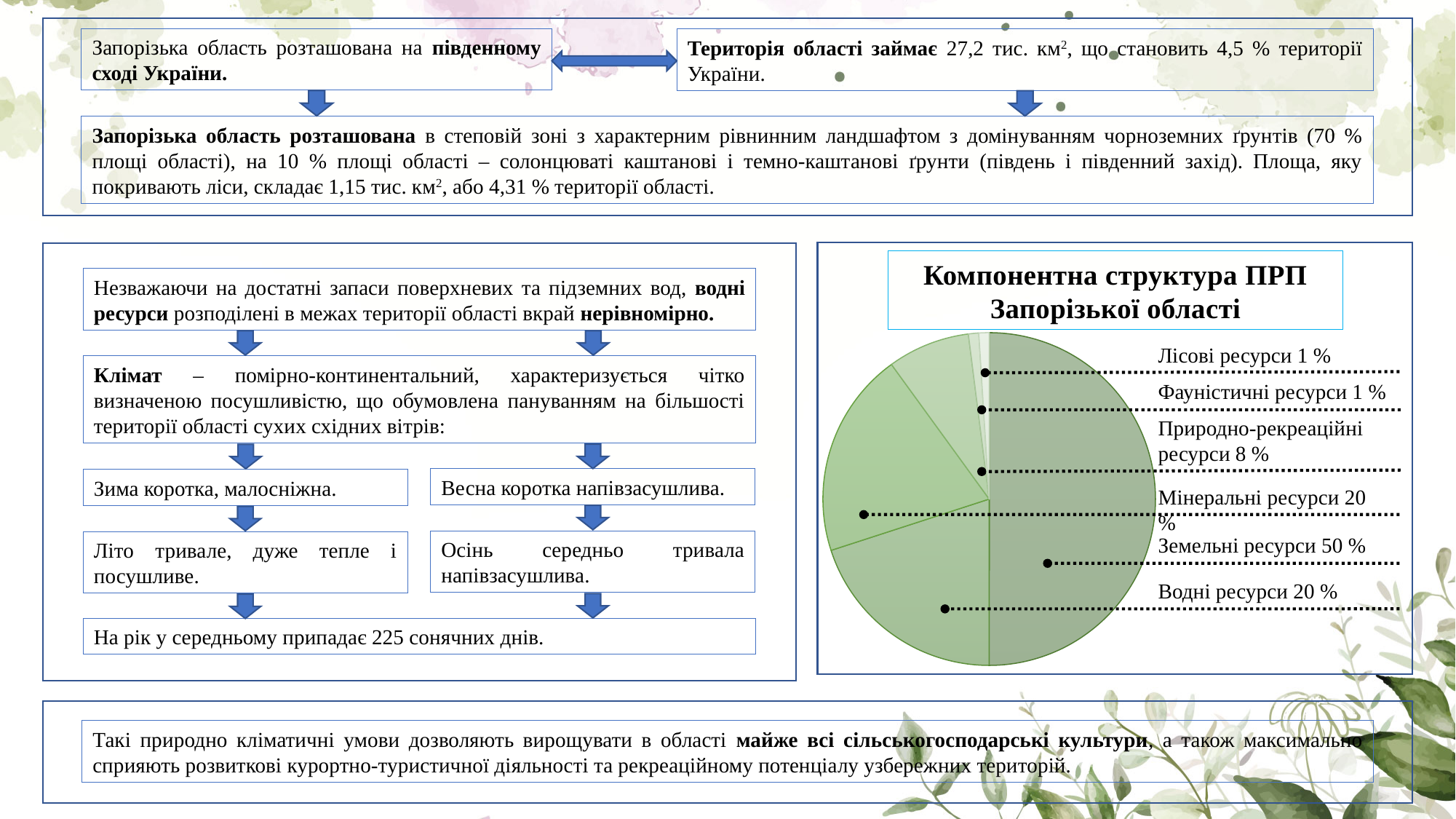
What share of the pie chart is Лісові ресурси? 1 % Which category has the largest slice of the pie chart? Земельні ресурси How many categories does the pie chart show? 6 What share of the pie chart is Земельні ресурси? 50 % What share of the pie chart is Природно-рекреаційні ресурси? 8 % What is the title of the chart? Компонентна структура ПРП Запорізької області What share of the pie chart is Мінеральні ресурси? 20 % What is the difference in percentage points between Земельні ресурси and Мінеральні ресурси? 30 What is the difference in percentage points between Природно-рекреаційні ресурси and Фауністичні ресурси? 7 What share of the pie chart is Водні ресурси? 20 % What kind of chart is shown on the slide? Pie chart Which is larger in the pie chart, Природно-рекреаційні ресурси or Водні ресурси? Водні ресурси